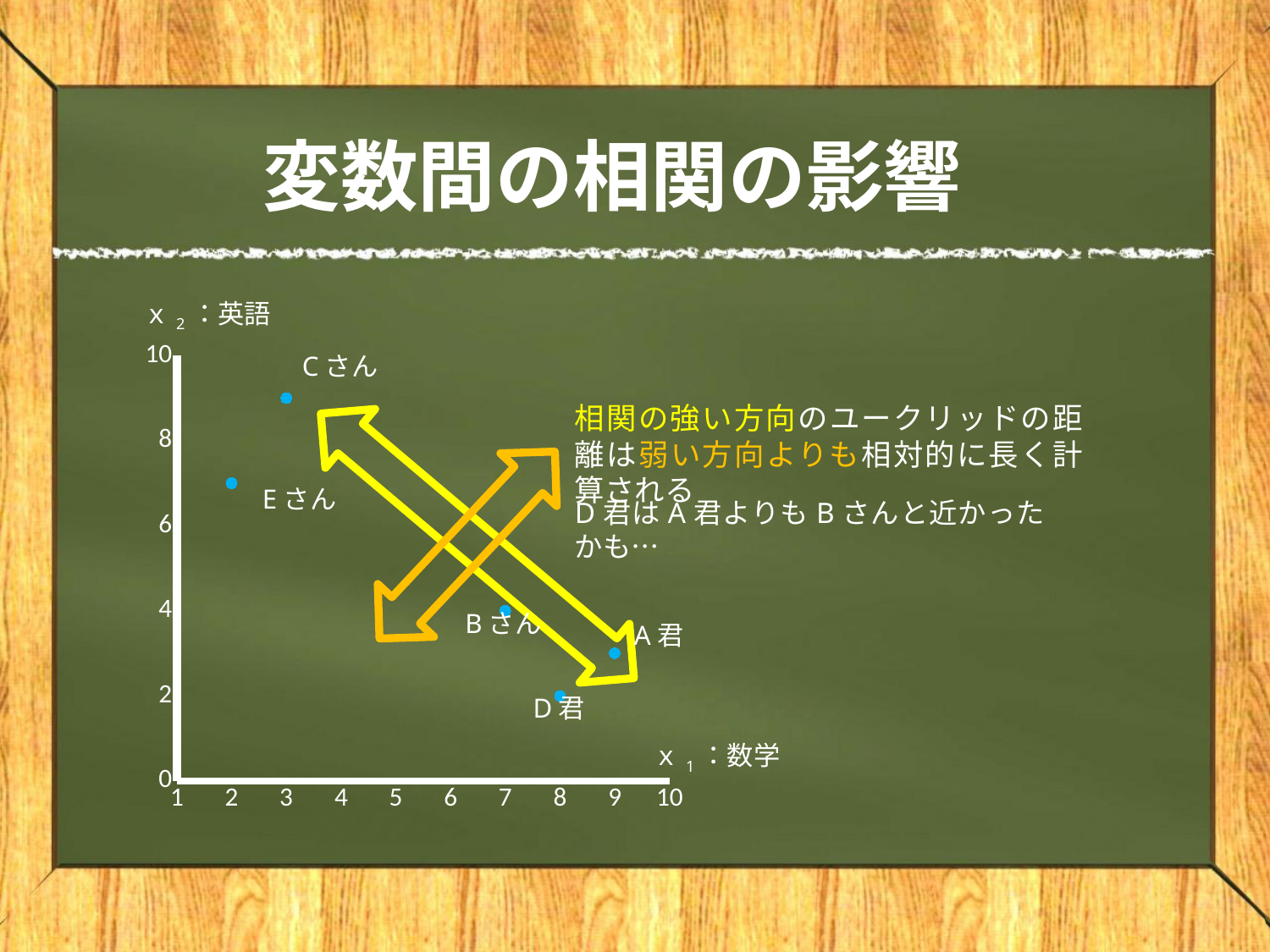
Which point has the lowest x1 (数学) value? Eさん What is the x1 (数学) value for A君? 9 What does the vertical axis x2 represent? 英語 What is the x1 (数学) value for Cさん? 3 How many data points are plotted on the chart? 5 Is the x2 (英語) value for A君 greater or less than 4? less Is the x2 (英語) value for Cさん greater or less than 8? greater What is the x1 (数学) value for Bさん? 7 Which has a larger x1 (数学) value, D君 or Bさん? D君 What is the x2 (英語) value for D君? 2 What kind of chart is shown on the slide? scatter plot Which point has the highest x2 (英語) value? Cさん